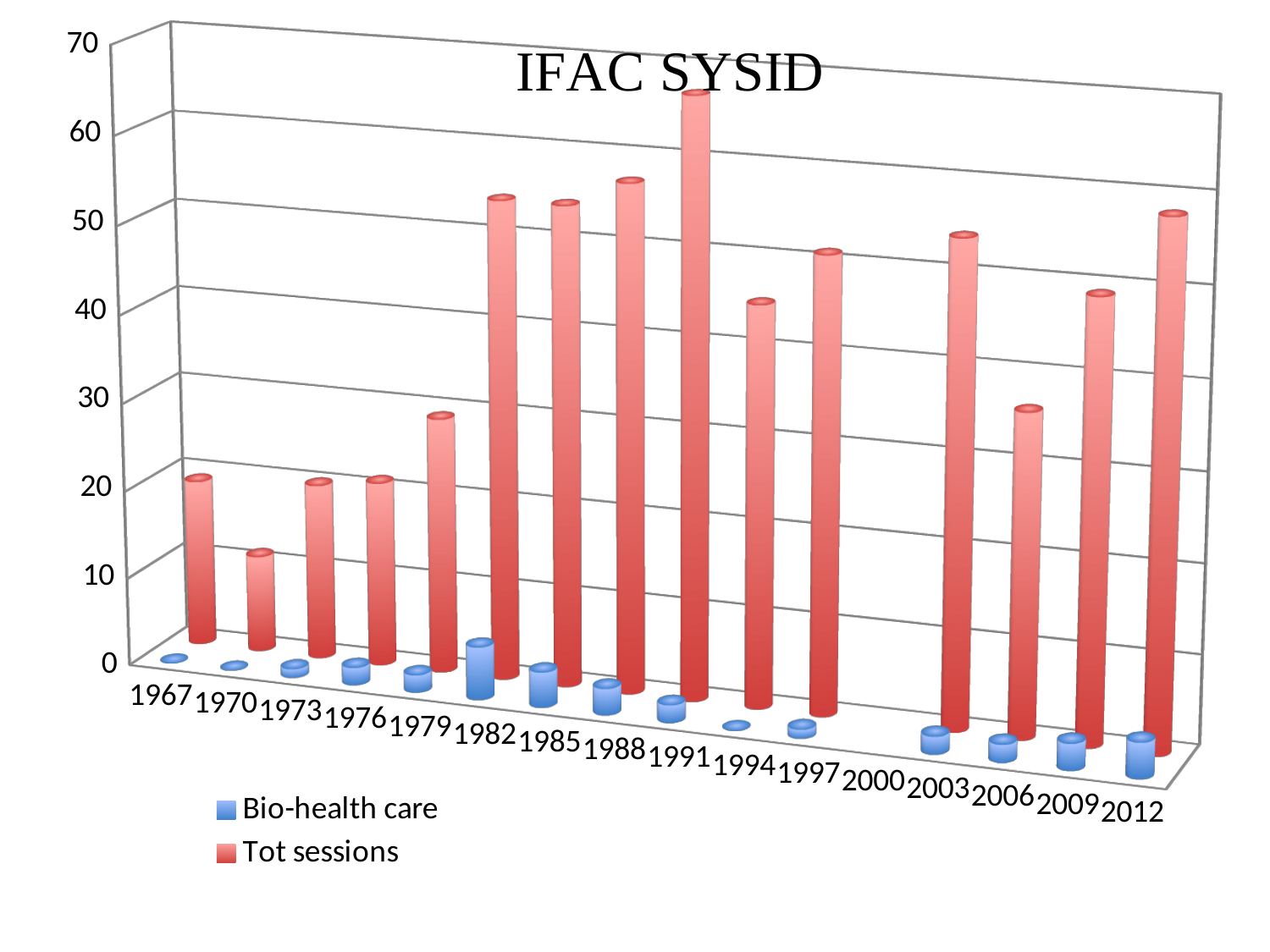
How many years are shown on the x axis? 16 Is the Tot sessions value for 1970 greater or less than 20? less Is the Tot sessions value for 1991 greater or less than 60? greater Which year has the larger Tot sessions value, 1979 or 1982? 1982 What is the title of the chart? IFAC SYSID Which year has the highest value for Tot sessions? 1991 Which colour represents the Bio-health care series? blue Is the Tot sessions value for 2006 greater or less than 40? less Which year has the larger Tot sessions value, 1991 or 1994? 1991 How many series does the legend list? 2 What kind of chart is shown on the slide? bar chart